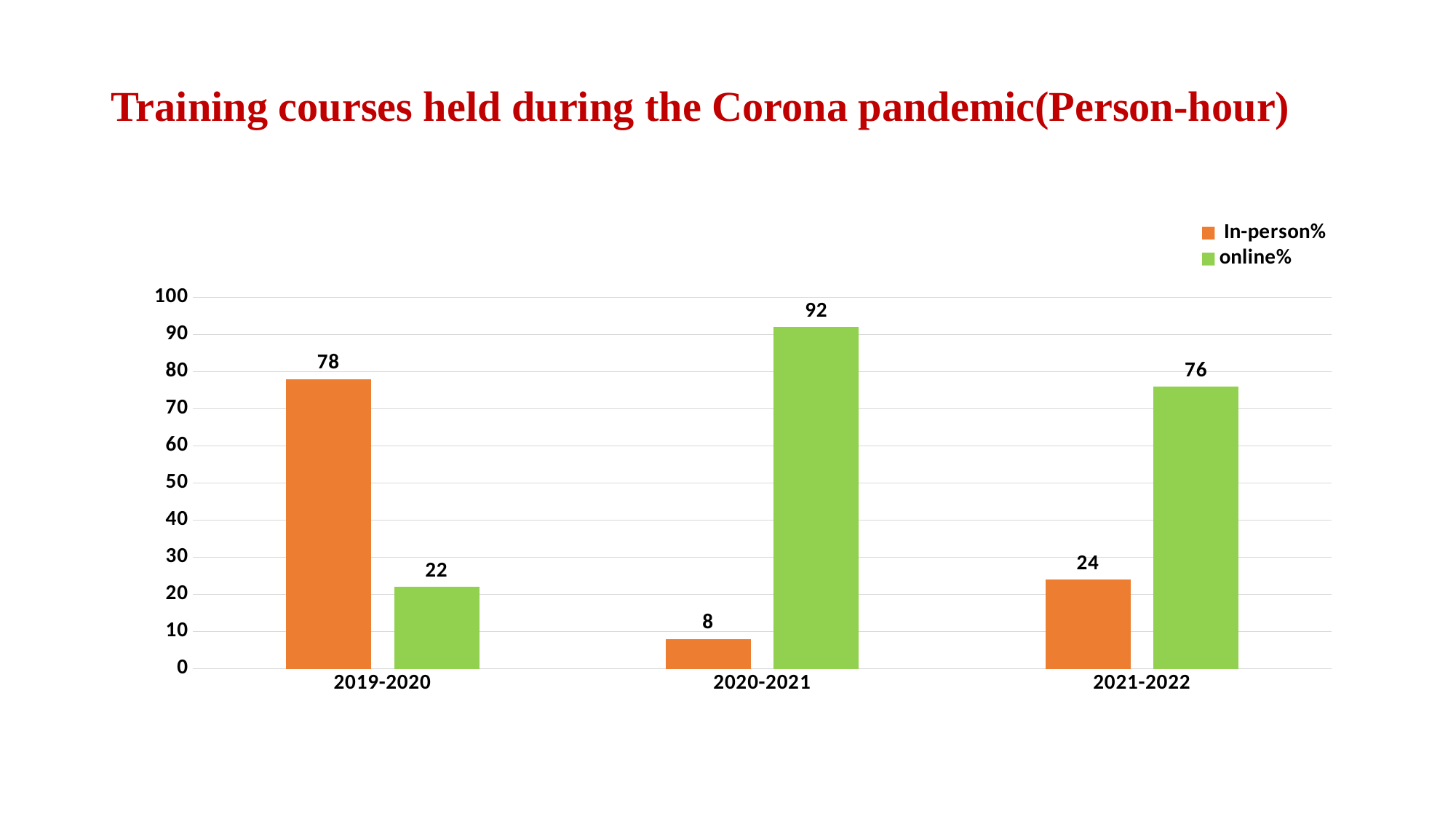
How many periods are shown on the x axis? 3 What is the online% value for 2019-2020? 22 What is the difference between the online% and In-person% values for 2021-2022? 52 What is the In-person% value for 2019-2020? 78 How many series does the legend list? 2 What colour represents the online% series? Green What kind of chart is shown on the slide? Bar chart Which is larger for 2019-2020, In-person% or online%? In-person% What is the online% value for 2020-2021? 92 Which period has the lowest In-person% value? 2020-2021 What is the In-person% value for 2021-2022? 24 Which period has the highest online% value? 2020-2021